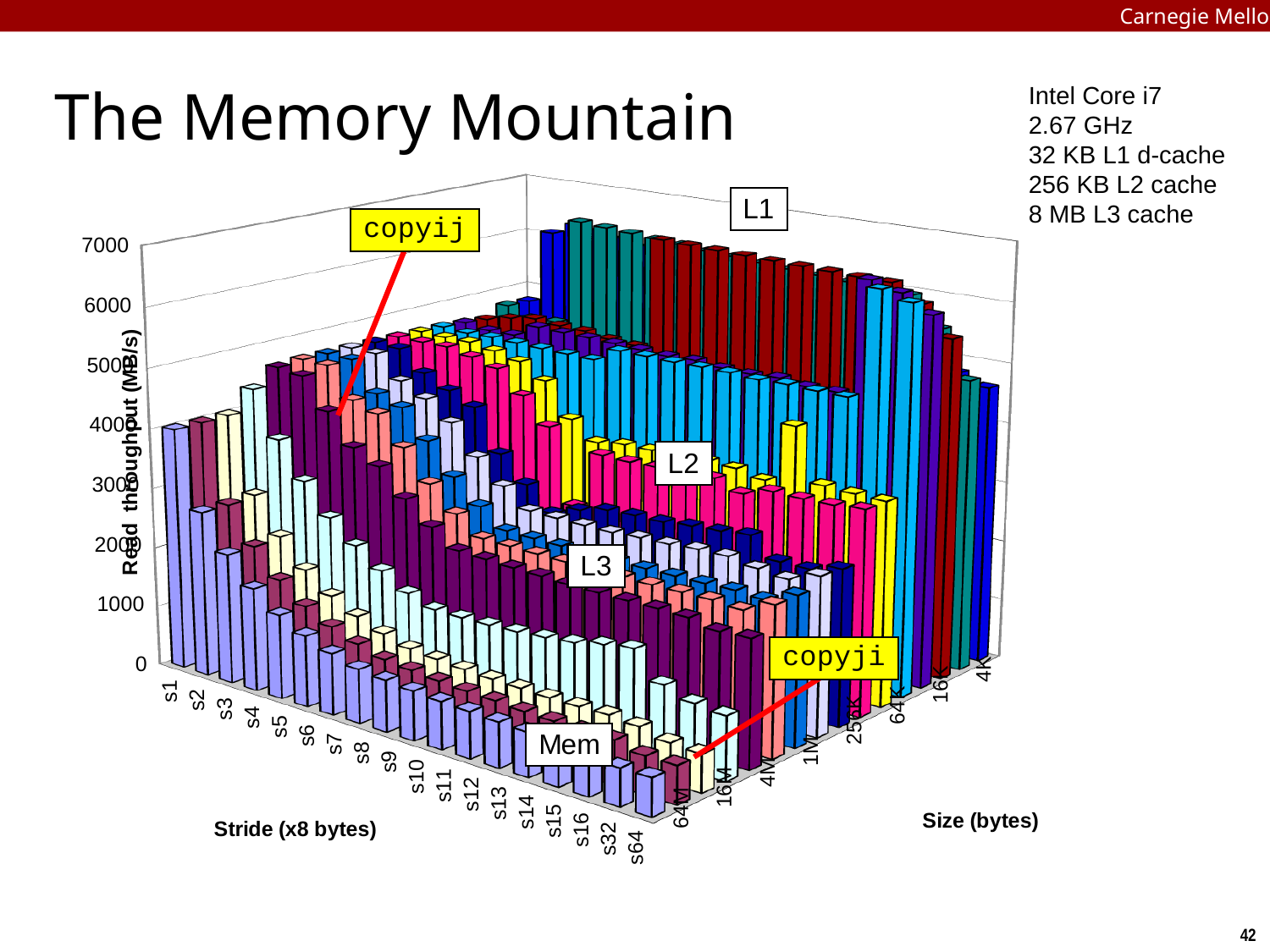
How many stride categories are shown along the Stride (x8 bytes) axis? 18 How many size categories are shown along the Size (bytes) axis? 16 Which cache level label is placed at the highest ridge of the chart? L1 What is the title of the chart on the slide? The Memory Mountain Is the read throughput for stride s1 at size 64M greater or less than 3000? greater What kind of chart is shown on the slide? 3D bar chart For size 64M, does read throughput rise or fall as the stride increases from s1 to s64? fall What is the label of the vertical axis of the chart? Read throughput (MB/s) Is the read throughput for stride s64 at size 64M greater or less than 1000? less Which size category has the tallest bars in the chart, 4K or 64M? 4K Which stride has the higher read throughput at size 64M, s1 or s64? s1